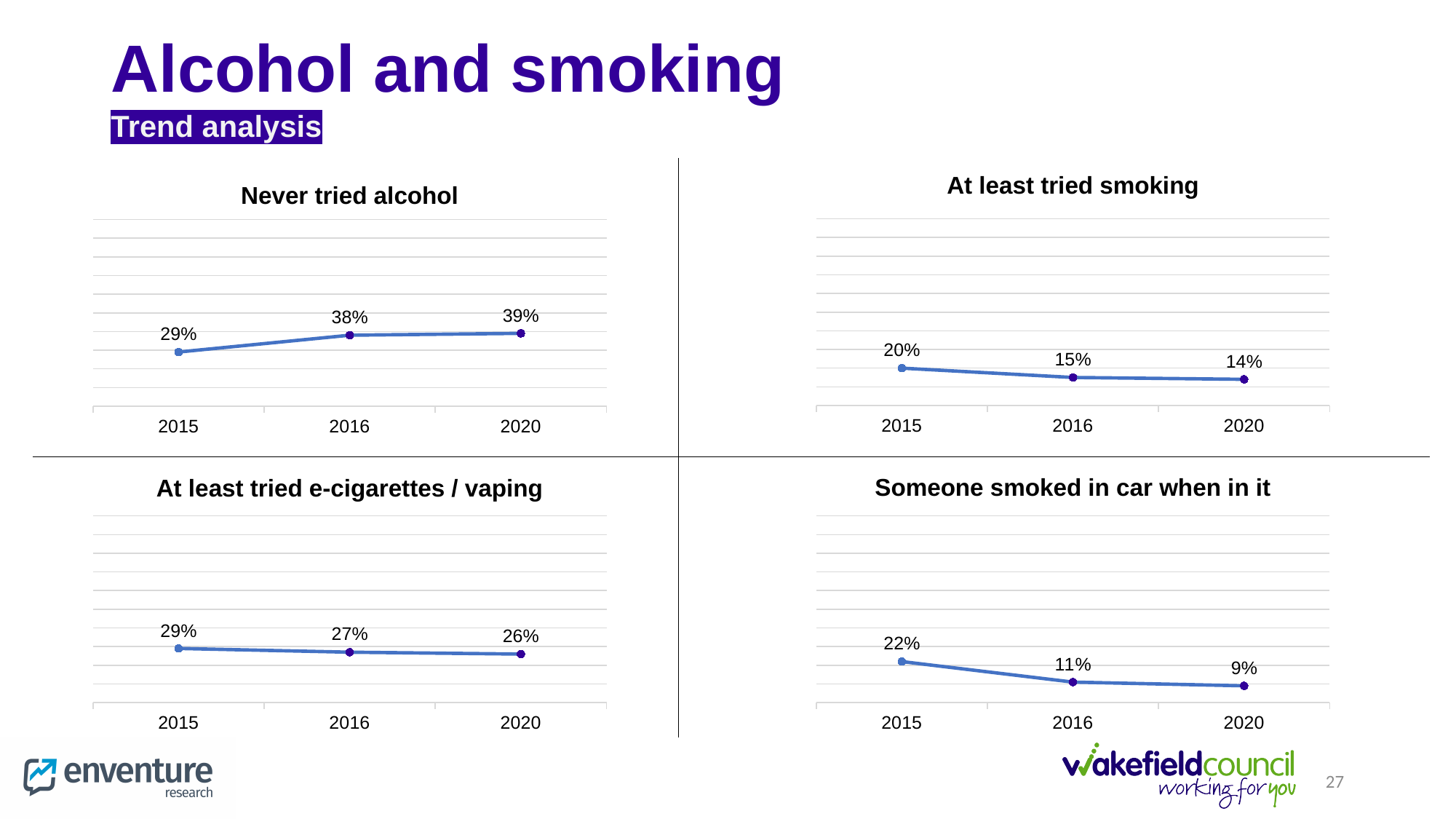
In the 'At least tried e-cigarettes / vaping' chart, which is larger, the value for 2015 or the value for 2020? 2015 In the 'Someone smoked in car when in it' chart, what is the value for 2016? 11% In the 'At least tried smoking' chart, what is the value for 2015? 20% How many data points are plotted in the 'Someone smoked in car when in it' chart? 3 What kind of chart is 'Never tried alcohol'? Line chart In the 'At least tried smoking' chart, do the values rise or fall from 2015 to 2020? Fall In the 'At least tried e-cigarettes / vaping' chart, which year has the highest value? 2015 In the 'Someone smoked in car when in it' chart, which year has the lowest value? 2020 In the 'At least tried smoking' chart, what is the difference between the 2015 and 2020 values? 6 percentage points In the 'Never tried alcohol' chart, what is the difference between the 2020 and 2015 values? 10 percentage points In the 'Never tried alcohol' chart, what is the value for 2020? 39% How many charts are shown on the slide? 4